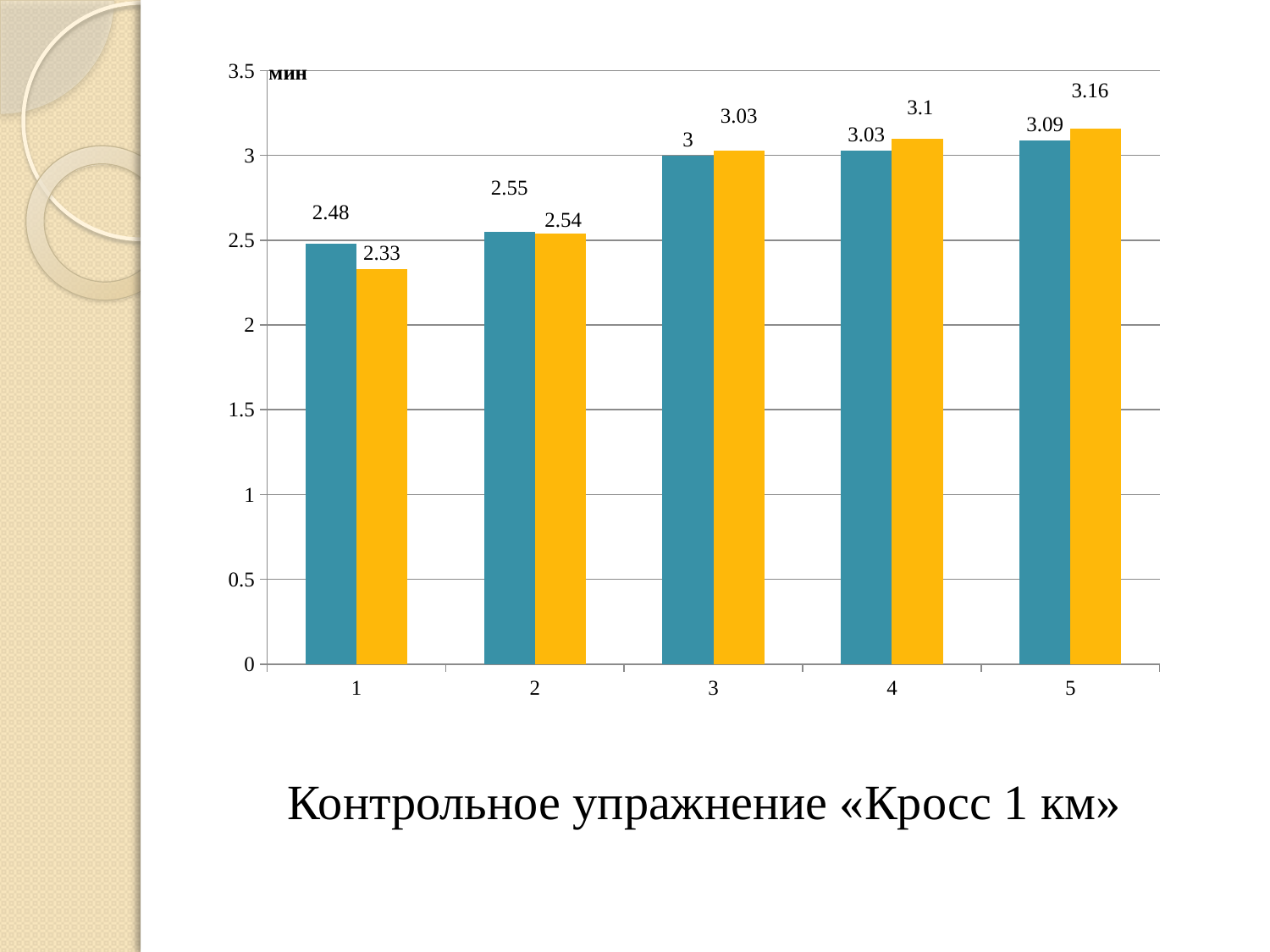
Which category has the highest orange bar? 5 What is the value of the blue bar for category 1? 2.48 What is the value of the orange bar for category 4? 3.1 What type of chart is shown on the slide? bar chart What is the value of the blue bar for category 5? 3.09 What unit label is shown at the top of the vertical axis? мин For category 1, which bar is larger, the blue one or the orange one? the blue one What is the value of the orange bar for category 1? 2.33 Do the values of the orange bars rise or fall from category 1 to category 5? rise How many categories are shown on the x axis of the chart? 5 What is the difference between the orange bar and the blue bar for category 5? 0.07 Which category has the lowest blue bar? 1